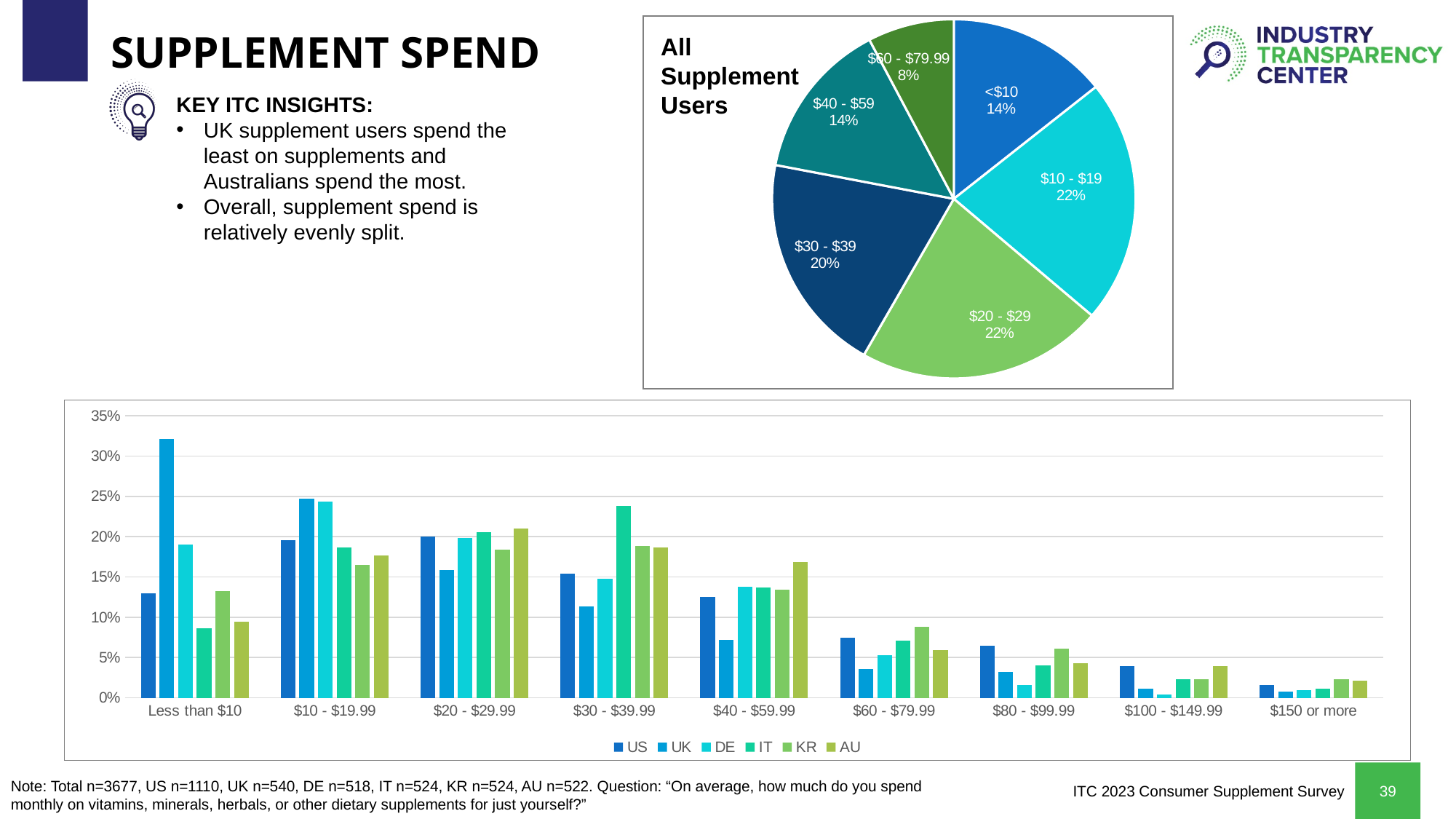
What type of chart is the chart at the bottom of the slide? bar chart In the pie chart titled "All Supplement Users", which slice is larger: $30 - $39 or $40 - $59? $30 - $39 How many slices does the pie chart titled "All Supplement Users" have? 6 In the bar chart at the bottom of the slide, which country has the highest value for "Less than $10"? UK In the pie chart titled "All Supplement Users", which spend bracket has the smallest share? $60 - $79.99 In the bar chart at the bottom of the slide, is the UK value for "Less than $10" greater or less than 30%? greater In the pie chart titled "All Supplement Users", how many percentage points larger is the $30 - $39 slice than the <$10 slice? 6% How many spend categories are shown on the x axis of the bar chart at the bottom of the slide? 9 In the pie chart titled "All Supplement Users", what share of users spend $60 - $79.99? 8% In the bar chart at the bottom of the slide, which country has the highest value for "$30 - $39.99"? IT How many series does the legend of the bar chart at the bottom of the slide list? 6 In the pie chart titled "All Supplement Users", what share of users spend $30 - $39? 20%